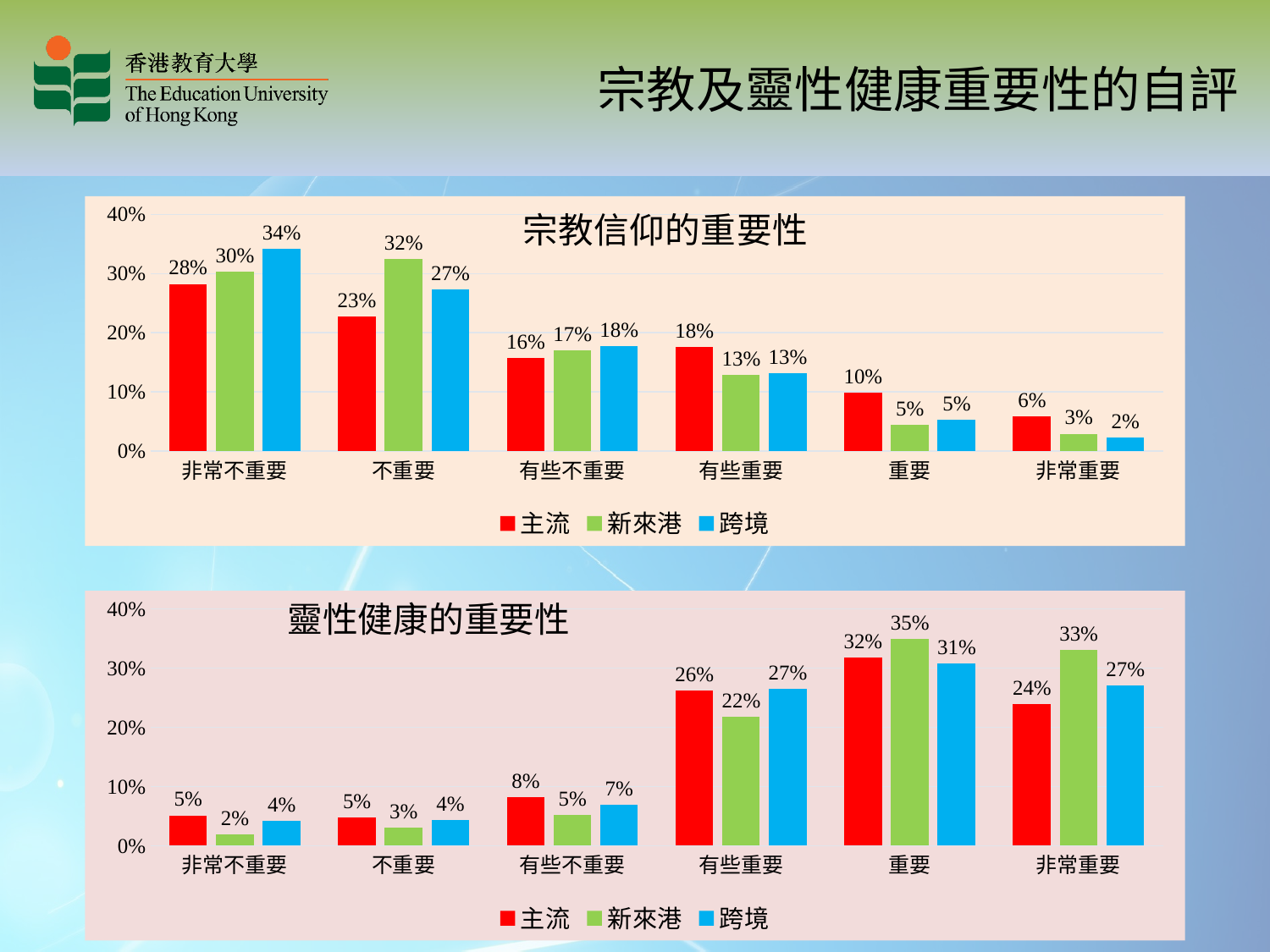
In the 宗教信仰的重要性 chart, what is the difference between 主流 and 新來港 in the 有些重要 category? 5% In the 靈性健康的重要性 chart, what is the value for 主流 in the 非常重要 category? 24% In the 靈性健康的重要性 chart, what is the difference between 新來港 and 主流 in the 非常重要 category? 9% In the 靈性健康的重要性 chart, what is the value for 新來港 in the 重要 category? 35% In the 靈性健康的重要性 chart, which category has the highest value for 主流? 重要 What type of chart is the 宗教信仰的重要性 chart? Bar chart In the 宗教信仰的重要性 chart, what is the value for 新來港 in the 不重要 category? 32% In the 靈性健康的重要性 chart, which is larger in the 非常重要 category: 新來港 or 跨境? 新來港 In the 宗教信仰的重要性 chart, which category has the lowest value for 跨境? 非常重要 How many categories are shown on the x axis of the 靈性健康的重要性 chart? 6 In the 宗教信仰的重要性 chart, how many series does the legend list? 3 In the 宗教信仰的重要性 chart, what is the value for 跨境 in the 非常不重要 category? 34%